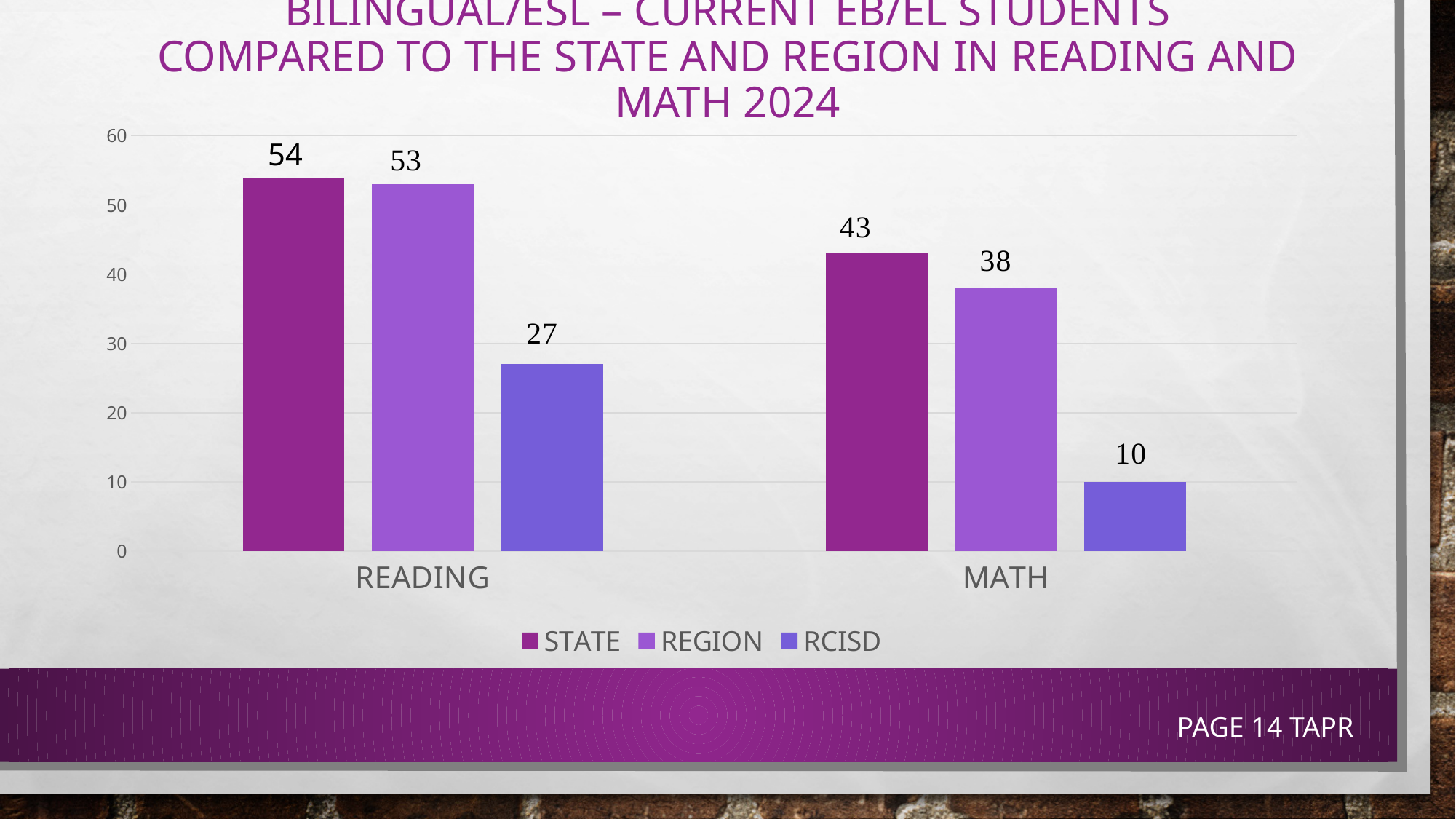
Which is larger, the RCISD value for READING or the RCISD value for MATH? READING What is the difference between the REGION and RCISD values for MATH? 28 What is the RCISD value for MATH? 10 Which series has the highest value for MATH? STATE Do the STATE values rise or fall from READING to MATH? Fall How many series does the legend list? 3 Which series has the lowest value for READING? RCISD What kind of chart is shown on the slide? Bar chart What is the STATE value for READING? 54 How many categories are shown on the x axis? 2 What is the difference between the STATE and RCISD values for READING? 27 What is the REGION value for MATH? 38